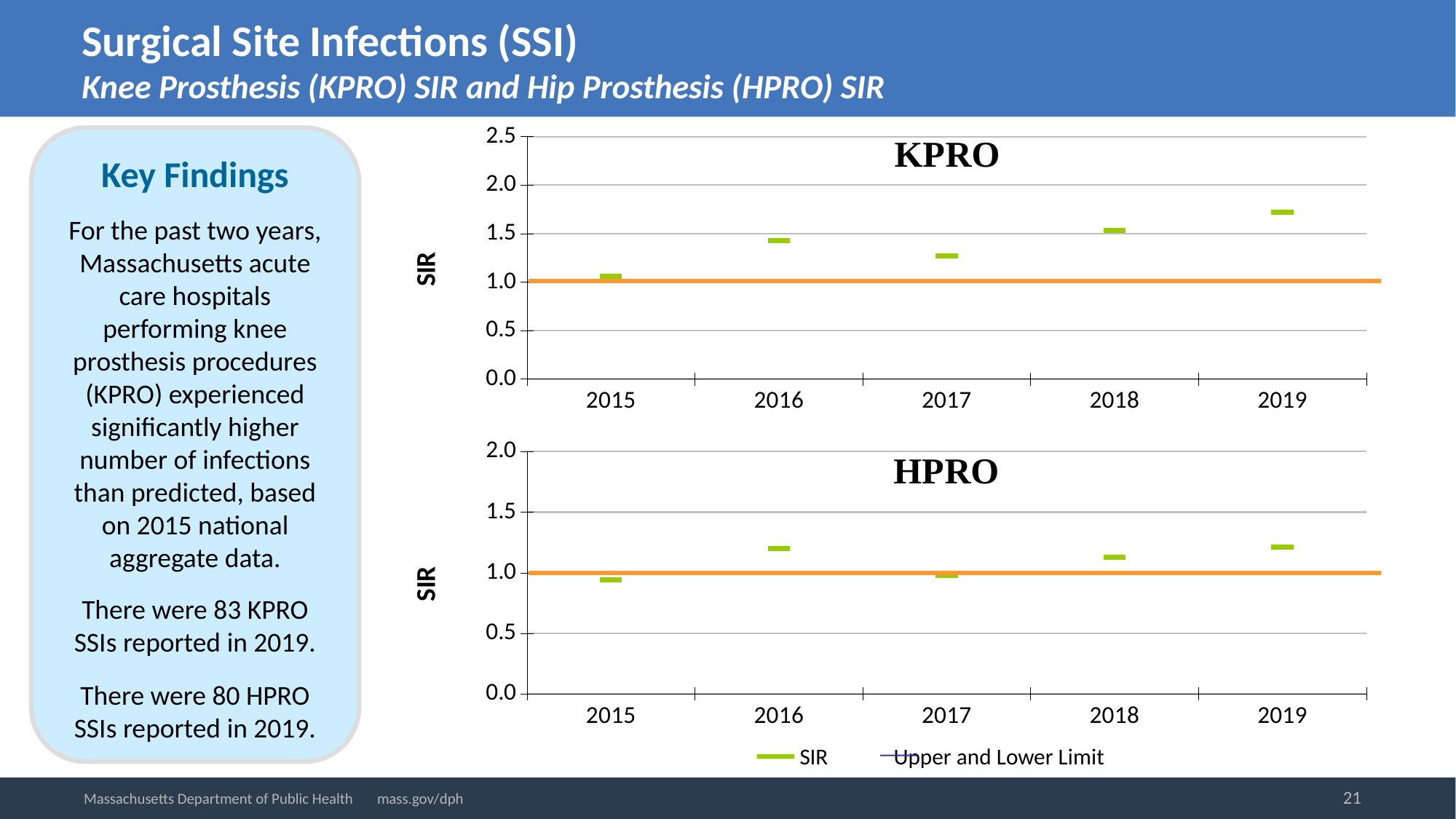
On the KPRO chart, which year has the highest SIR? 2019 What is the label on the vertical axis of the KPRO chart? SIR On the HPRO chart, is the SIR for 2018 greater or less than 1.0? greater How many series does the legend below the HPRO chart list? 2 On the KPRO chart, is the SIR for 2017 greater or less than 1.5? less On the HPRO chart, is the SIR for 2015 greater or less than 1.0? less On the KPRO chart, which year has the lowest SIR? 2015 How many years are plotted on the HPRO chart? 5 On the KPRO chart, is the SIR for 2019 larger than the SIR for 2015? Yes On the KPRO chart, does the SIR rise or fall from 2017 to 2019? rise